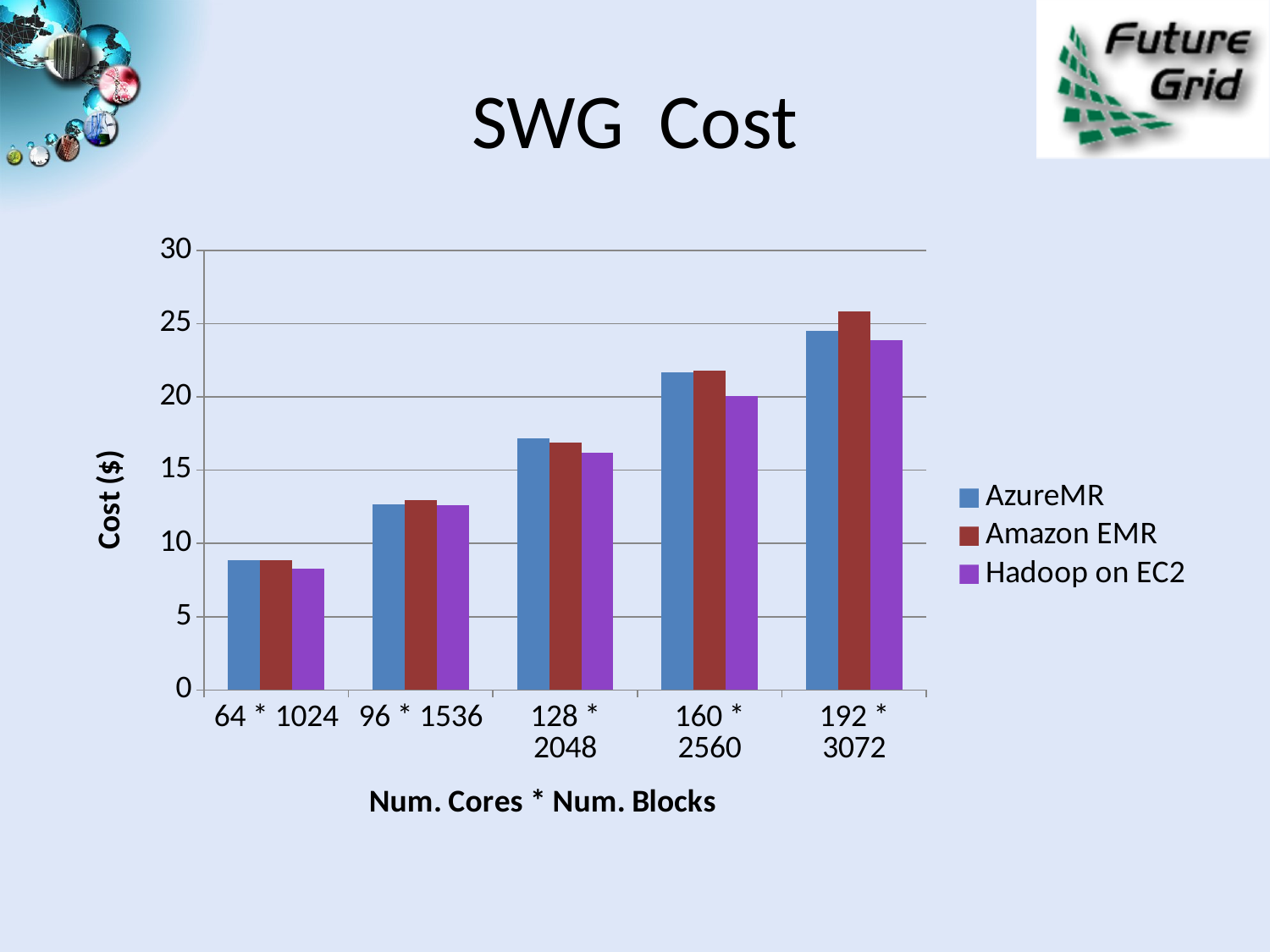
Do the costs rise or fall as Num. Cores * Num. Blocks increases along the x axis? rise How many categories are shown on the x axis? 5 What is the title of the x axis? Num. Cores * Num. Blocks Is the value for Hadoop on EC2 at 64 * 1024 greater or less than 10? less At 192 * 3072, which is larger: Amazon EMR or Hadoop on EC2? Amazon EMR Which category has the highest costs? 192 * 3072 Is the value for AzureMR at 128 * 2048 greater or less than 15? greater How many series does the legend list? 3 What kind of chart is shown on the slide? bar chart What is the title of the y axis? Cost ($) Which category has the lowest costs? 64 * 1024 Is the value for Amazon EMR at 192 * 3072 greater or less than 25? greater